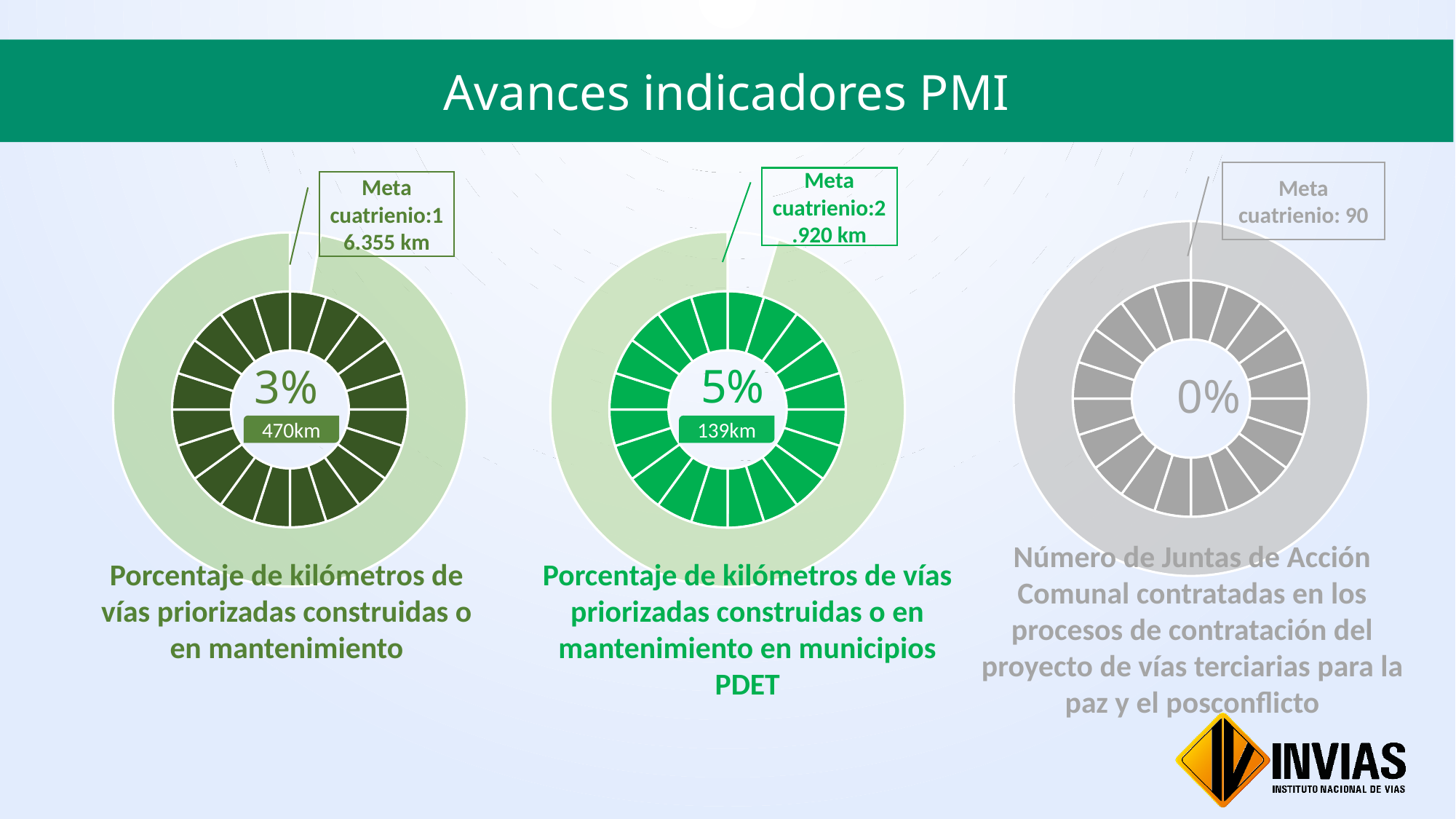
In the left chart, 'Porcentaje de kilómetros de vías priorizadas construidas o en mantenimiento', how many kilometres are shown below the percentage? 470km Which is larger: the percentage in the left chart (vías priorizadas) or the percentage in the middle chart (municipios PDET)? The middle chart (municipios PDET), 5% What kind of chart is used for each indicator on the slide? Donut chart In the middle chart, 'Porcentaje de kilómetros de vías priorizadas construidas o en mantenimiento en municipios PDET', what percentage is shown in the centre? 5% In the left chart, 'Porcentaje de kilómetros de vías priorizadas construidas o en mantenimiento', what percentage is shown in the centre? 3% What is the difference in percentage points between the middle chart (5%) and the left chart (3%)? 2 percentage points Which of the three indicator charts on the slide shows the highest percentage? Porcentaje de kilómetros de vías priorizadas construidas o en mantenimiento en municipios PDET (5%) How many circular indicator charts are shown on the slide? 3 Which of the three indicator charts on the slide shows the lowest percentage? Número de Juntas de Acción Comunal contratadas (0%) In the right chart, 'Número de Juntas de Acción Comunal contratadas', what is the 'Meta cuatrienio' value shown in the callout box? 90 In the right chart, 'Número de Juntas de Acción Comunal contratadas', what percentage is shown in the centre? 0% In the middle chart, 'Porcentaje de kilómetros de vías priorizadas construidas o en mantenimiento en municipios PDET', how many kilometres are shown below the percentage? 139km